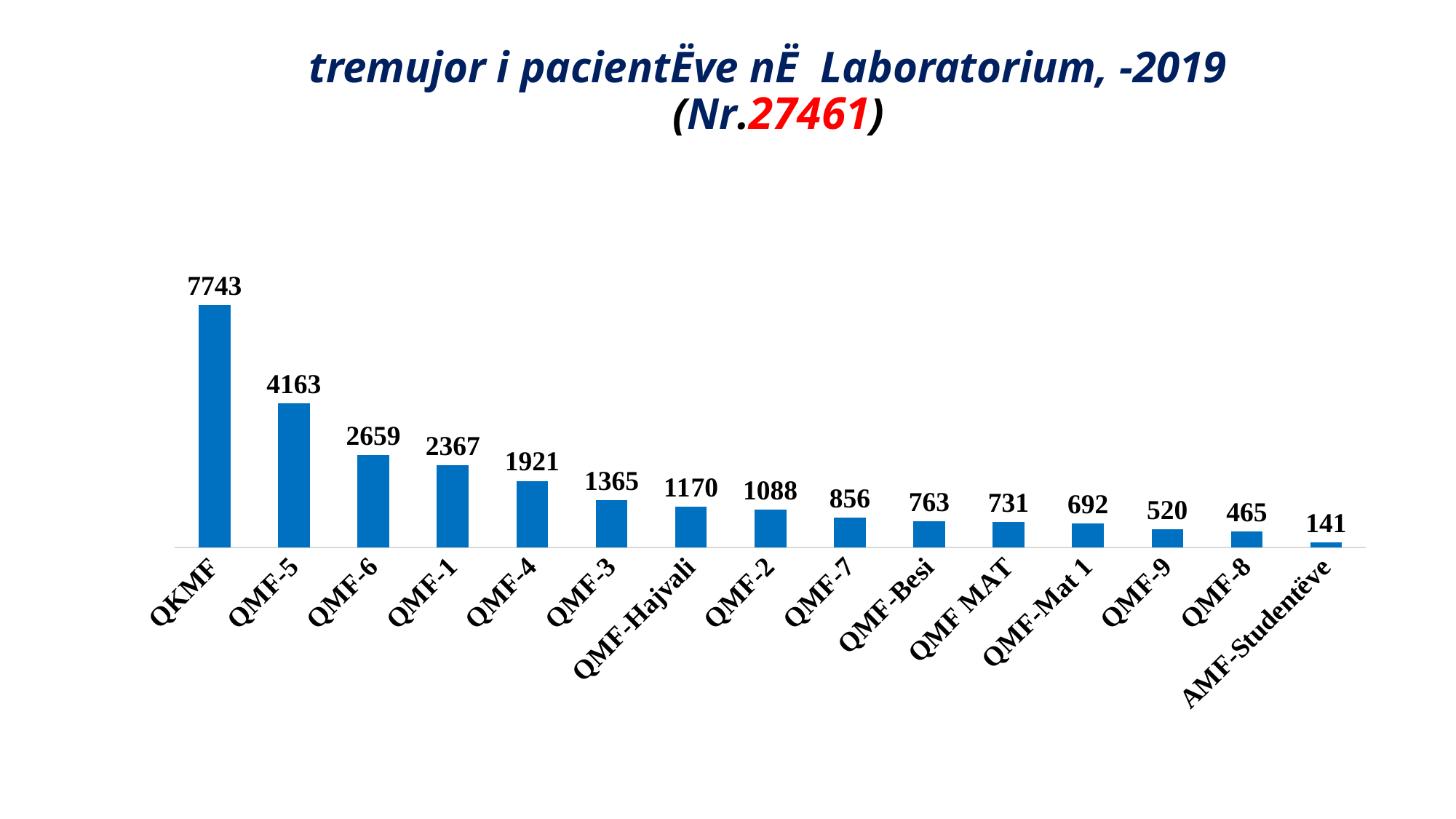
Which category has the lowest value? AMF-Studentëve What kind of chart is this? bar chart What is the value for QMF-Mat 1? 692 What is the value for QMF-Hajvali? 1170 Do the values rise or fall from left to right along the x axis? fall What is the difference between the values for QKMF and QMF-5? 3580 How many categories are shown on the x axis? 15 What is the value for AMF-Studentëve? 141 What is the difference between the values for QMF-6 and QMF-1? 292 Which is larger, the value for QMF-3 or the value for QMF-2? QMF-3 Which category has the highest value? QKMF What is the value for QKMF? 7743